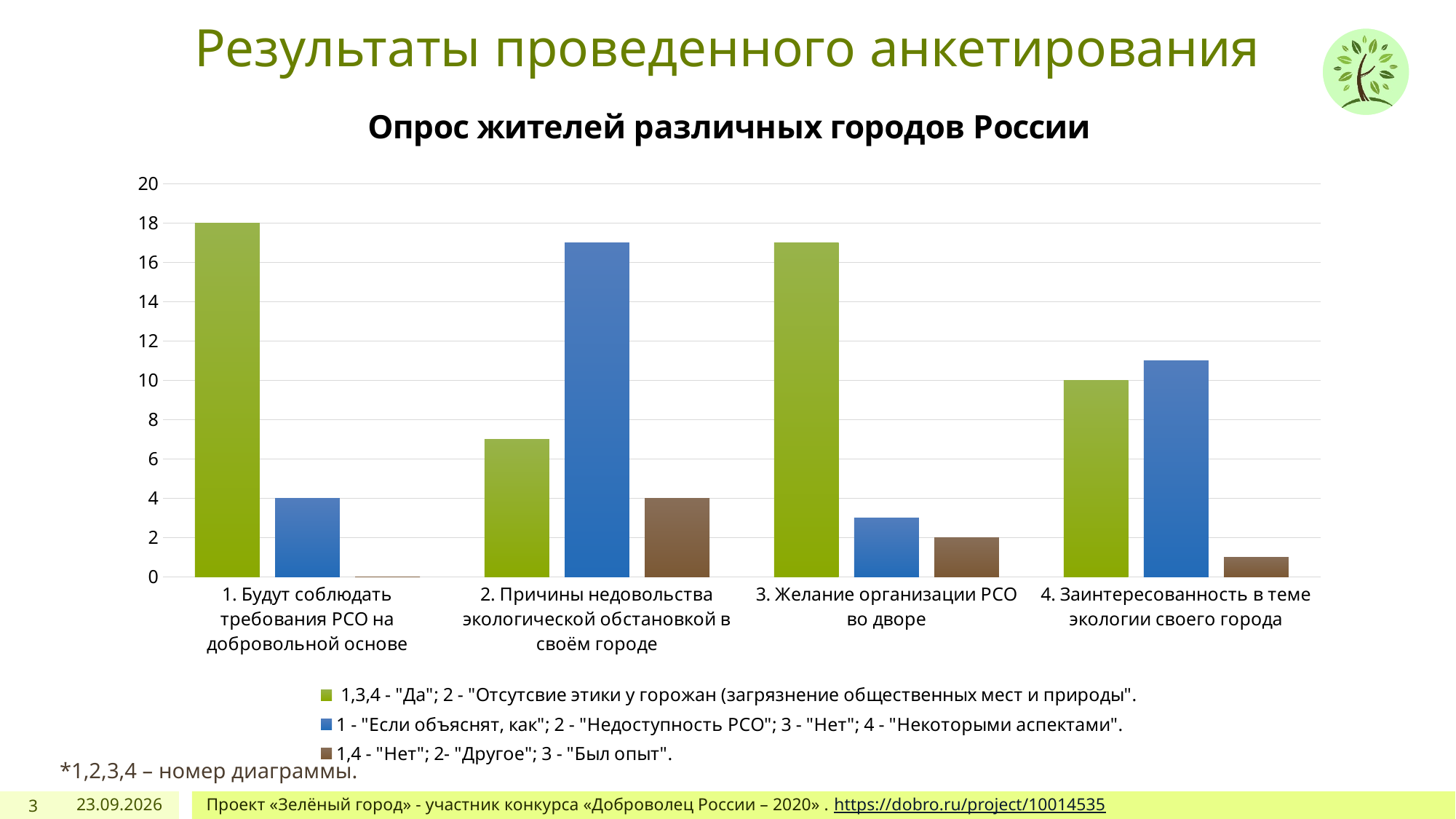
Which category has the highest green bar? 1. Будут соблюдать требования РСО на добровольной основе What is the value of the blue bar for category "1. Будут соблюдать требования РСО на добровольной основе"? 4 What type of chart is shown on the slide? bar chart Is the value of the blue bar for category "4. Заинтересованность в теме экологии своего города" greater or less than 10? greater Which is larger for category "3. Желание организации РСО во дворе": the green bar or the blue bar? the green bar What is the value of the green bar for category "1. Будут соблюдать требования РСО на добровольной основе"? 18 How many series does the chart legend list? 3 Which category has the highest blue bar? 2. Причины недовольства экологической обстановкой в своём городе How many categories are shown on the x axis of the chart? 4 What is the value of the green bar for category "4. Заинтересованность в теме экологии своего города"? 10 What is the value of the brown bar for category "2. Причины недовольства экологической обстановкой в своём городе"? 4 What is the title of the chart? Опрос жителей различных городов России